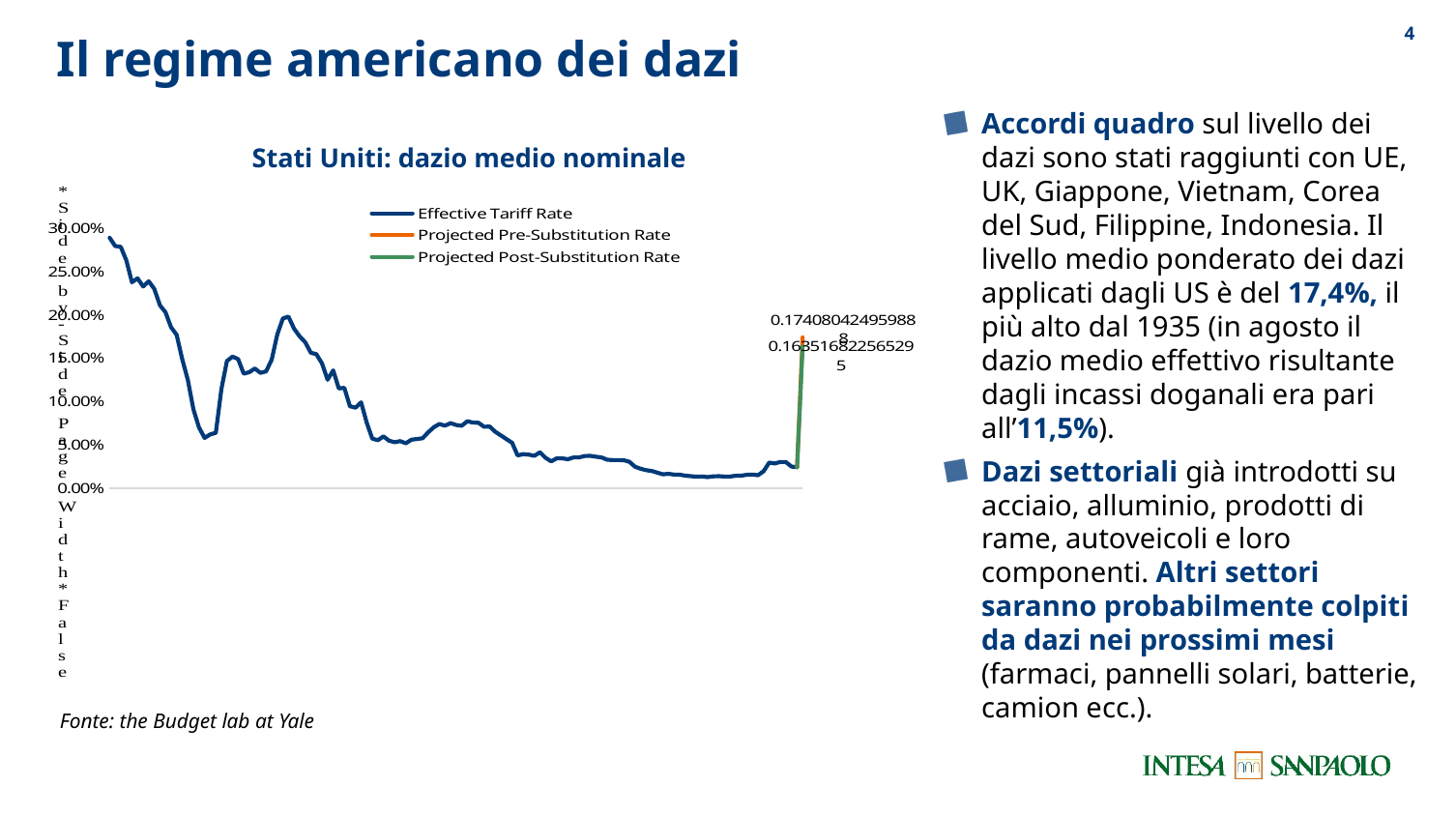
Are the projected rates at the right end of the chart greater or less than 20.00%? less What colour is the Effective Tariff Rate line in the chart? Dark blue Does the Effective Tariff Rate line generally rise or fall from the left of the chart to the point just before the projected spike at the right? Fall Is the lowest point of the Effective Tariff Rate line greater or less than 5.00%? less Is the Effective Tariff Rate at the far left of the chart greater or less than 25.00%? greater What is the title of the chart on the slide? Stati Uniti: dazio medio nominale What kind of chart is shown on the slide? Line chart Which is larger: the Effective Tariff Rate at the far left of the chart or the Effective Tariff Rate just before the projected spike at the right? The value at the far left How many series does the legend of the chart list? 3